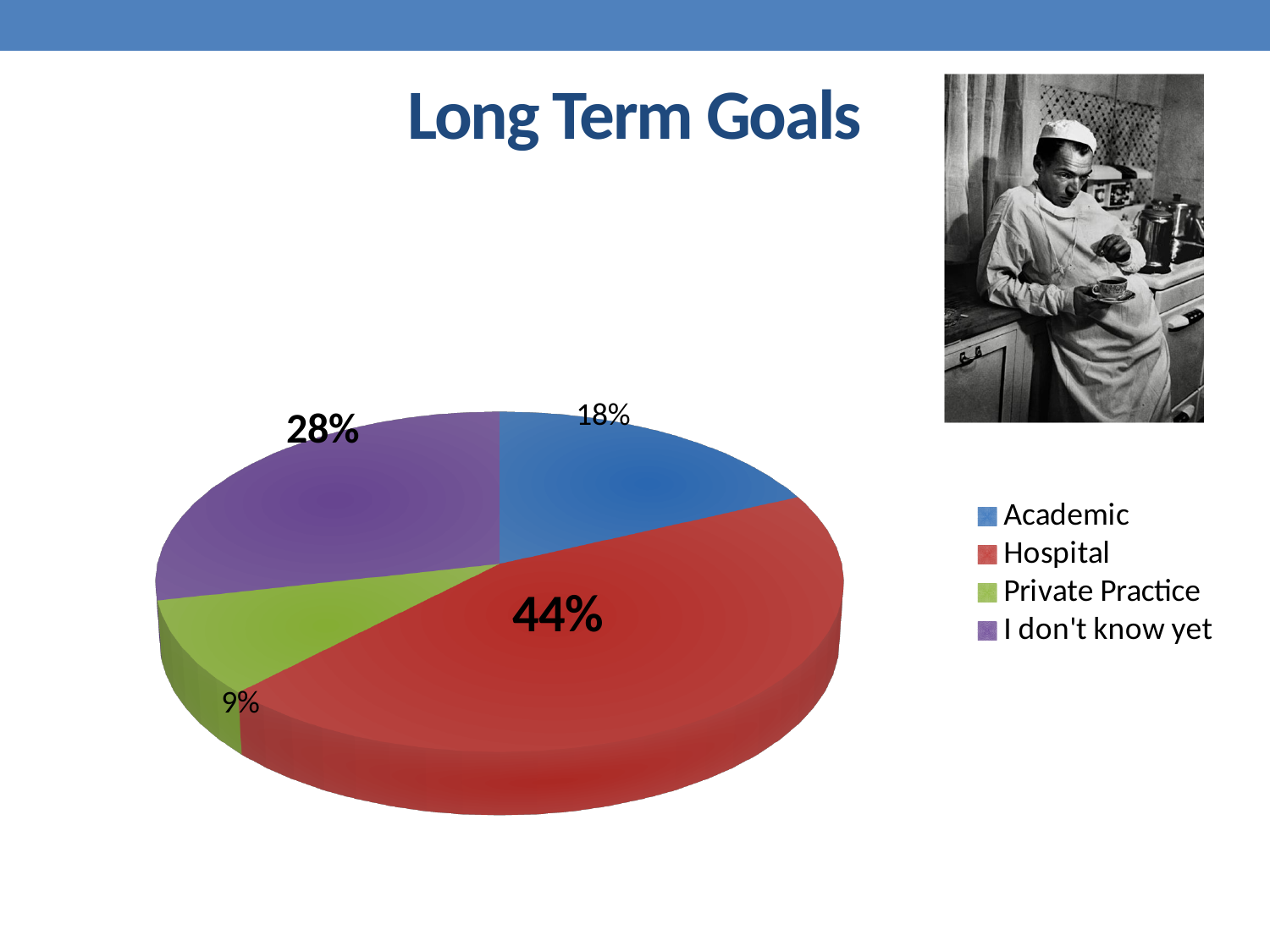
Which category has the smallest slice of the pie? Private Practice How many categories does the pie chart have? 4 What share of the pie does Private Practice represent? 9% Which category has the largest slice of the pie? Hospital What share of the pie does Academic represent? 18% What share of the pie does Hospital represent? 44% What colour is the Hospital slice? red What kind of chart is shown on the slide? pie chart What is the title of the chart? Long Term Goals Which is larger, the slice for Academic or the slice for 'I don't know yet'? I don't know yet What is the difference in percentage points between Hospital and Academic? 26